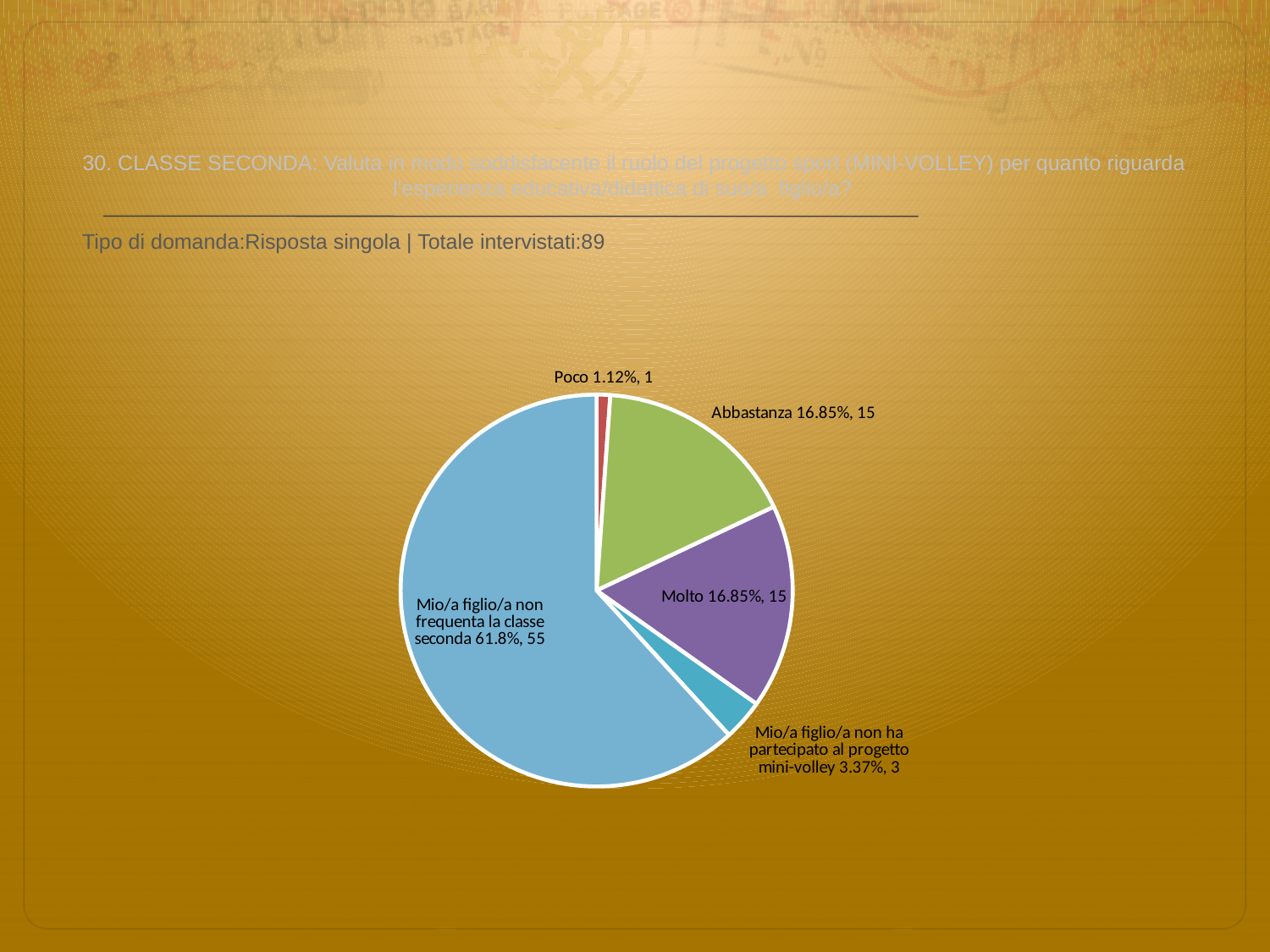
What kind of chart is shown on the slide? pie chart How many respondents answered "Molto"? 15 How many respondents answered "Poco"? 1 What percentage share does the "Abbastanza" slice have? 16.85% How many slices does the pie chart have? 5 Which has more respondents, "Abbastanza" or "Mio/a figlio/a non ha partecipato al progetto mini-volley"? Abbastanza What is the difference in respondent count between "Mio/a figlio/a non frequenta la classe seconda" and "Molto"? 40 What percentage share does the "Mio/a figlio/a non frequenta la classe seconda" slice have? 61.8% How many respondents chose "Mio/a figlio/a non ha partecipato al progetto mini-volley"? 3 Which category has the largest slice of the pie? Mio/a figlio/a non frequenta la classe seconda What is the total number of respondents (Totale intervistati) stated on the slide? 89 Which category has the smallest slice of the pie? Poco